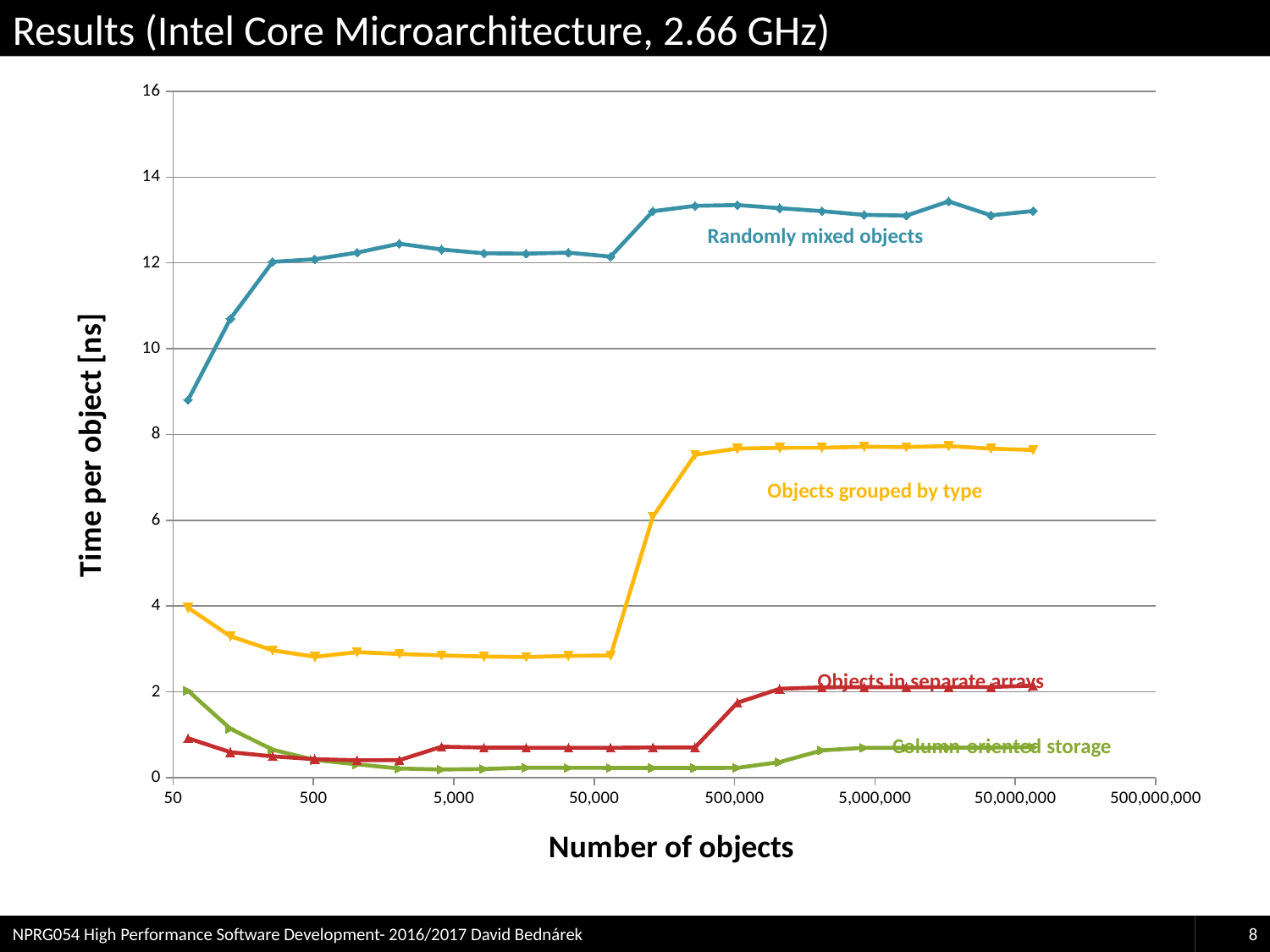
What is the label of the x axis? Number of objects At 500,000 objects, which series has the larger time per object: Randomly mixed objects or Objects grouped by type? Randomly mixed objects What kind of chart is shown on the slide? line chart Is the value for Objects grouped by type at 50,000,000 objects greater or less than 6 ns? greater Which series has the lowest time per object across the chart? Column-oriented storage What is the label of the y axis? Time per object [ns] Which series has the highest time per object across the chart? Randomly mixed objects How many data series are plotted on the chart? 4 Is the value for Objects grouped by type at 5,000 objects greater or less than 4 ns? less Does the Objects grouped by type series rise or fall between 50,000 and 500,000 objects? rise Is the value for Column-oriented storage at 5,000 objects greater or less than 2 ns? less